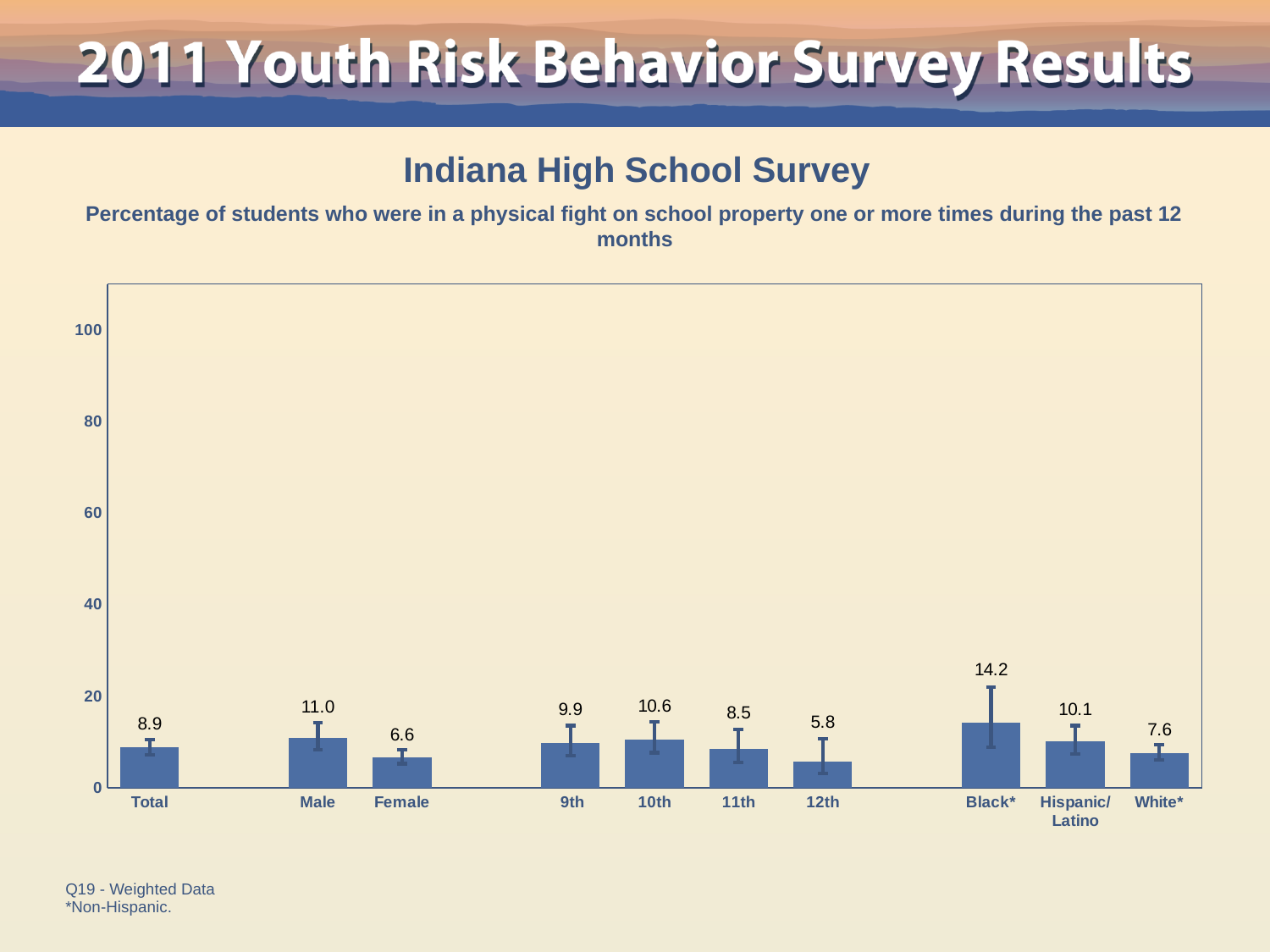
What is the value for 12th grade? 5.8 Is the value for Black* greater or less than 20? less Which category has the highest value? Black* What kind of chart is shown on the slide? bar chart What is the value for Hispanic/Latino? 10.1 Which category has the lowest value? 12th What is the value for Total? 8.9 What is the difference between the values for Male and Female? 4.4 What is the value for Male? 11.0 What is the value for Female? 6.6 How many categories are shown on the x axis? 10 Which is larger, the value for 9th or the value for 10th? 10th